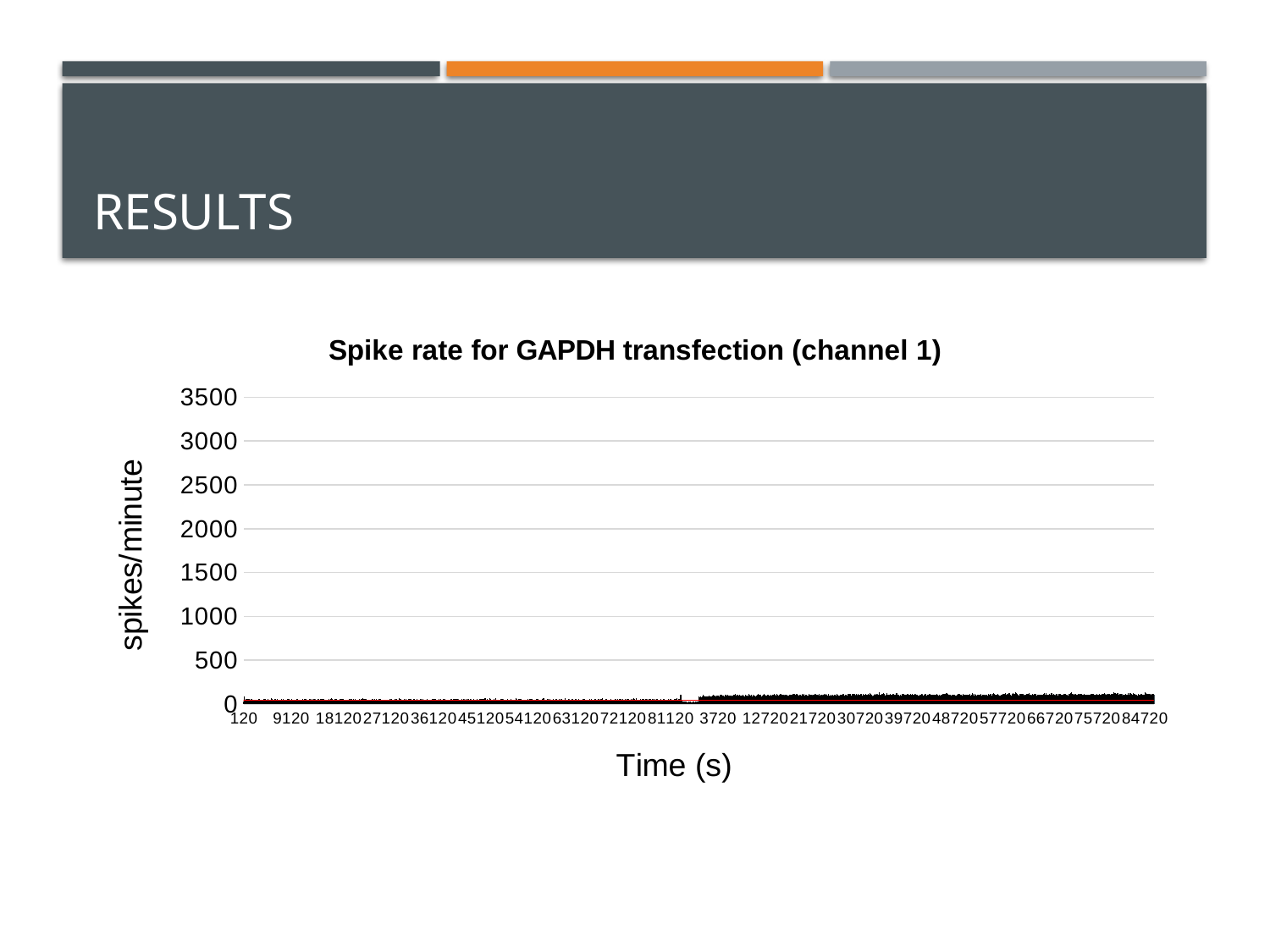
What is the label of the vertical axis of the chart? spikes/minute What is the highest value shown on the vertical axis of the chart? 3500 What is the first time value shown on the horizontal axis of the chart? 120 What is the title of the chart? Spike rate for GAPDH transfection (channel 1) Does the plotted spike rate ever rise above 1500 spikes/minute? No What kind of chart is shown on the slide? line chart